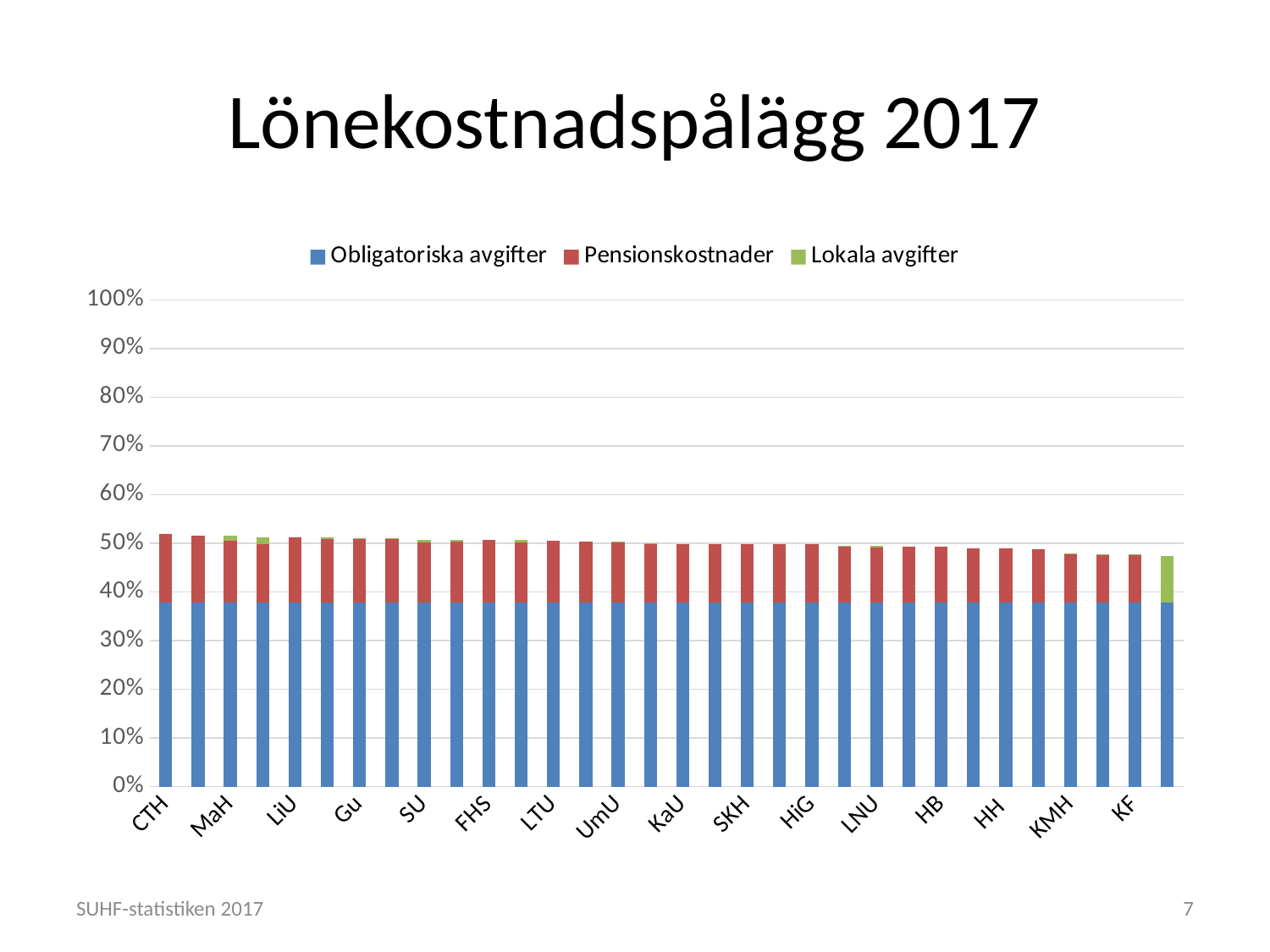
How many category labels are printed on the x axis? 16 What is the title of the chart? Lönekostnadspålägg 2017 Which has the larger total stacked value, CTH or KF? CTH What kind of chart is shown on the slide? Stacked bar chart Is the Obligatoriska avgifter value for CTH greater or less than 40%? less Is the total stacked value for CTH greater or less than 50%? greater Is the Obligatoriska avgifter value for HB greater or less than 30%? greater How many series does the legend list? 3 Do the total stacked values rise or fall moving from left to right along the x axis? fall Which series is shown in green in the legend? Lokala avgifter For CTH, which series is larger, Obligatoriska avgifter or Pensionskostnader? Obligatoriska avgifter